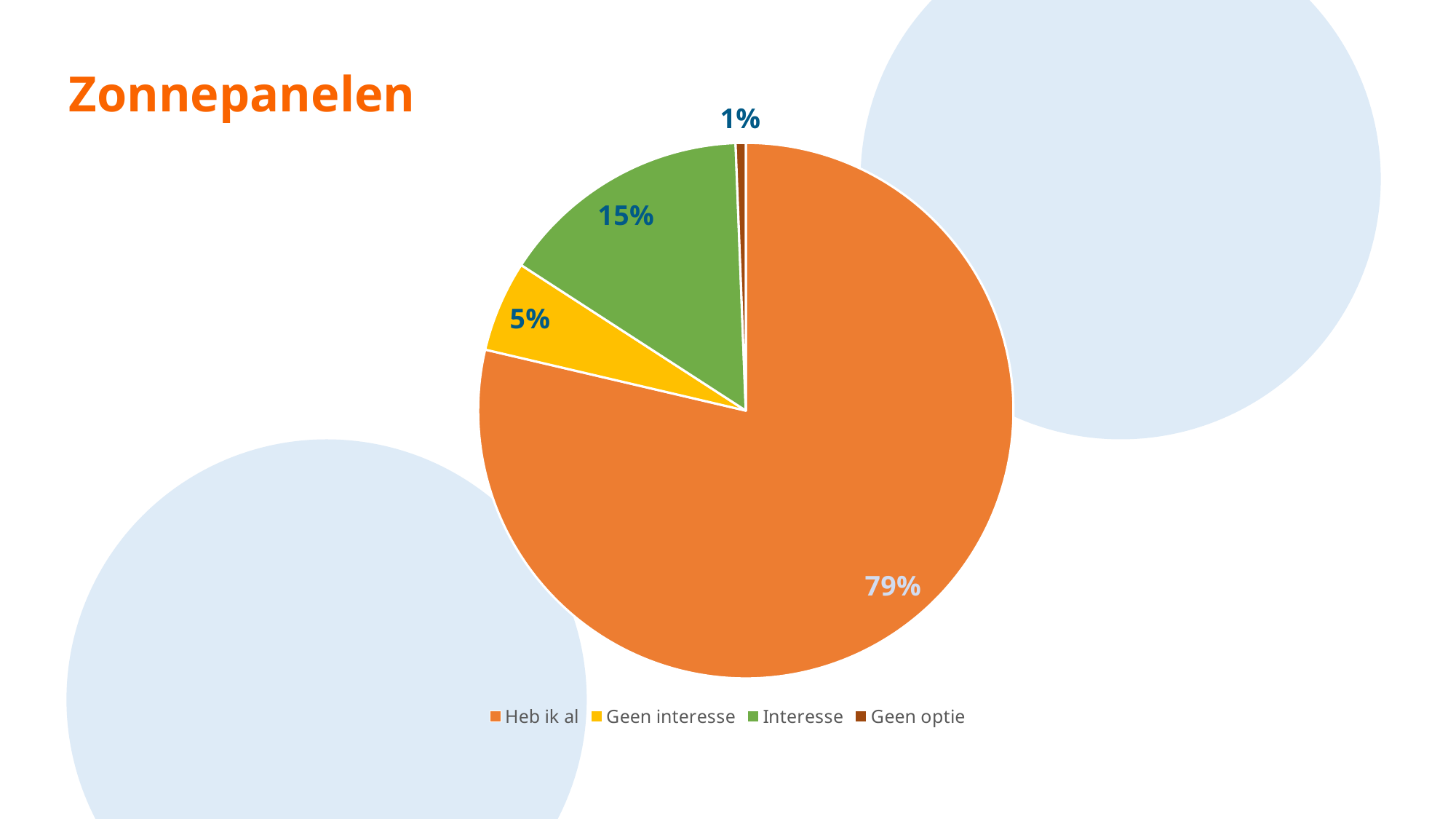
What kind of chart is shown on the slide? Pie chart What is the difference in percentage points between "Heb ik al" and "Interesse"? 64 Which category has the smallest slice of the pie? Geen optie What is the difference in percentage points between "Interesse" and "Geen interesse"? 10 What is the title of the slide containing the chart? Zonnepanelen Which category has the largest slice of the pie? Heb ik al What share of the pie does "Geen optie" represent? 1% Which is larger, the slice for "Interesse" or the slice for "Geen interesse"? Interesse What share of the pie does "Geen interesse" represent? 5% What share of the pie does "Interesse" represent? 15% How many categories does the pie chart show? 4